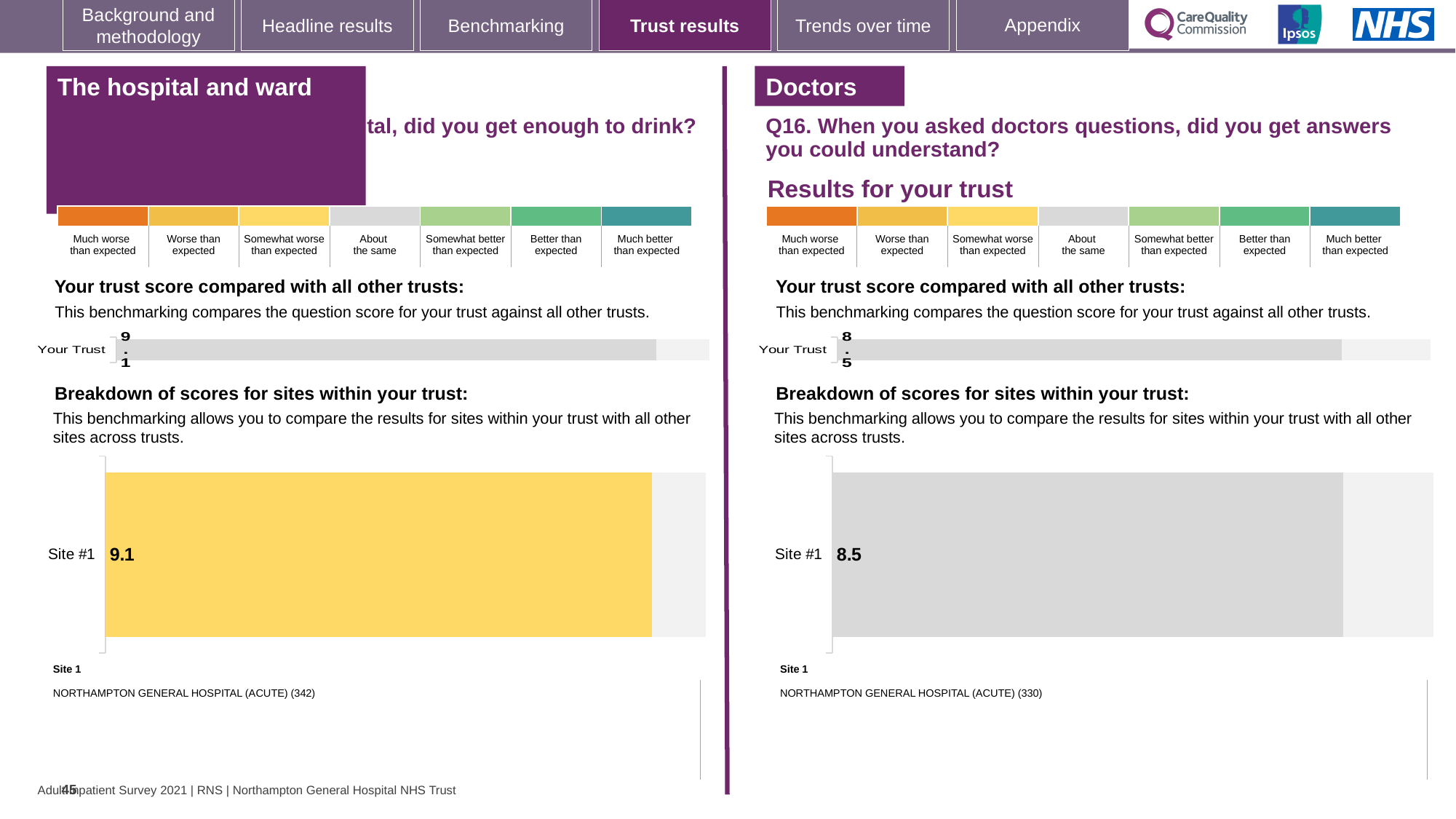
On the left-hand breakdown chart, what colour is the Site #1 bar? Yellow On the left-hand 'Your trust score compared with all other trusts' chart, what is the score for Your Trust? 9.1 Which is larger: the Site #1 score on the left-hand breakdown chart or the Site #1 score on the right-hand breakdown chart? Left-hand (9.1) How many sites are shown on the right-hand 'Breakdown of scores for sites within your trust' chart? 1 On the right-hand 'Breakdown of scores for sites within your trust' chart (Doctors, Q16), what is the score for Site #1? 8.5 On the right-hand breakdown chart (Doctors, Q16), what colour is the Site #1 bar? Grey Which site name is listed as Site 1 under the right-hand breakdown chart? NORTHAMPTON GENERAL HOSPITAL (ACUTE) (330) What is the difference between the Your Trust score on the left-hand chart (9.1) and the Your Trust score on the right-hand chart (8.5)? 0.6 On the left-hand 'Breakdown of scores for sites within your trust' chart, what is the score for Site #1? 9.1 What type of chart is used for the 'Breakdown of scores for sites within your trust' on the left-hand side? Bar chart How many sites are shown on the left-hand 'Breakdown of scores for sites within your trust' chart? 1 On the right-hand 'Your trust score compared with all other trusts' chart (Doctors, Q16), what is the score for Your Trust? 8.5